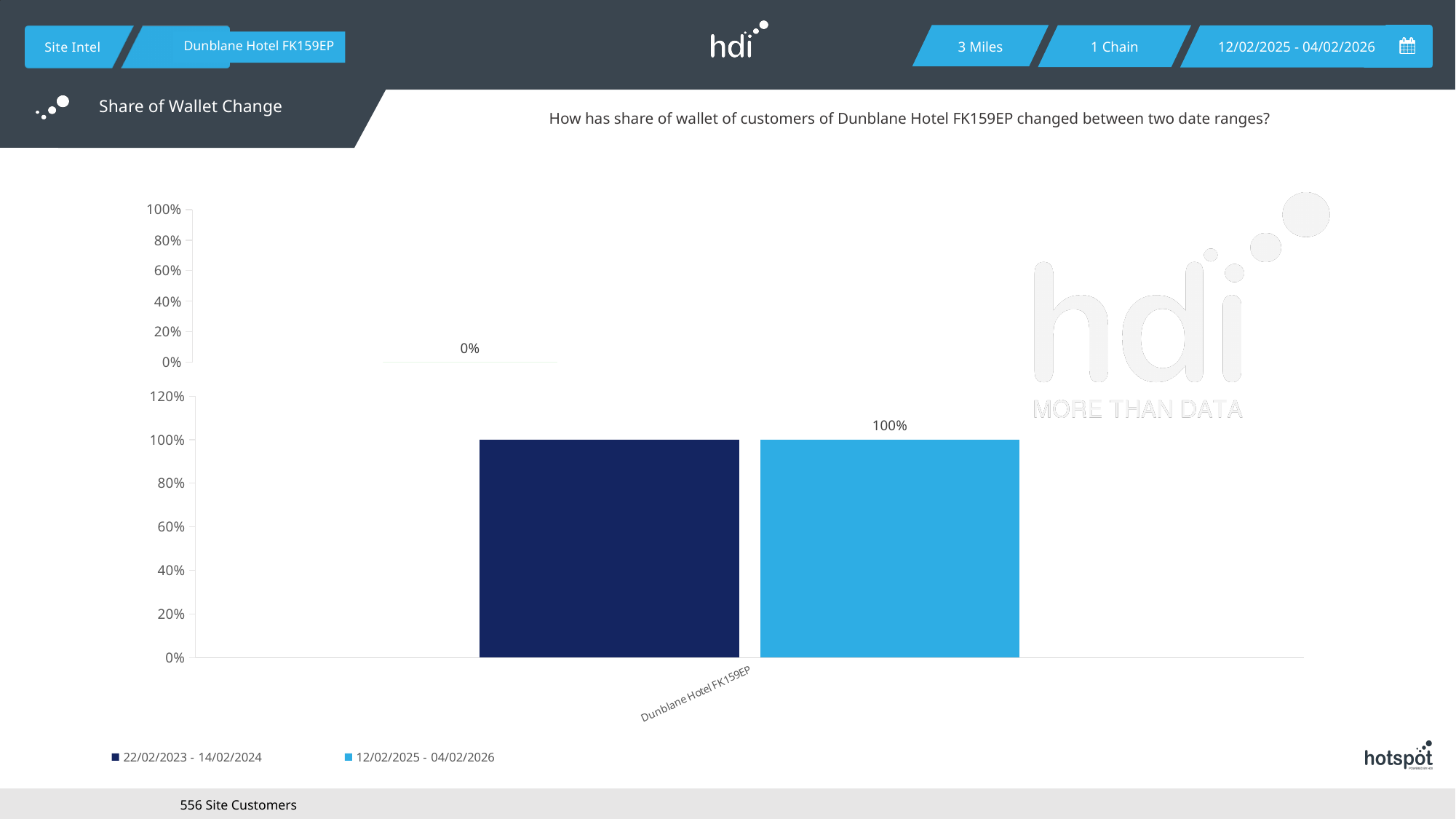
In the lower chart, is the value for the 22/02/2023 - 14/02/2024 series greater or less than 60%? greater In the lower chart, what is the value for the 22/02/2023 - 14/02/2024 series for Dunblane Hotel FK159EP? 100% In the lower chart, what is the difference between the 22/02/2023 - 14/02/2024 value and the 12/02/2025 - 04/02/2026 value for Dunblane Hotel FK159EP? 0% In the lower chart, how many categories are shown on the x axis? 1 In the lower chart, what is the value for the 12/02/2025 - 04/02/2026 series for Dunblane Hotel FK159EP? 100% In the upper chart, what value is labelled for Dunblane Hotel FK159EP? 0% In the lower chart, is the value for the 12/02/2025 - 04/02/2026 series greater or less than 80%? greater In the lower chart, what is the highest value shown on the y axis? 120% What is the title of the chart section on the slide? Share of Wallet Change In the lower chart, what colour is the bar for the 22/02/2023 - 14/02/2024 series? dark navy blue What kind of chart is the lower chart on the slide? bar chart In the lower chart, how many series does the legend list? 2